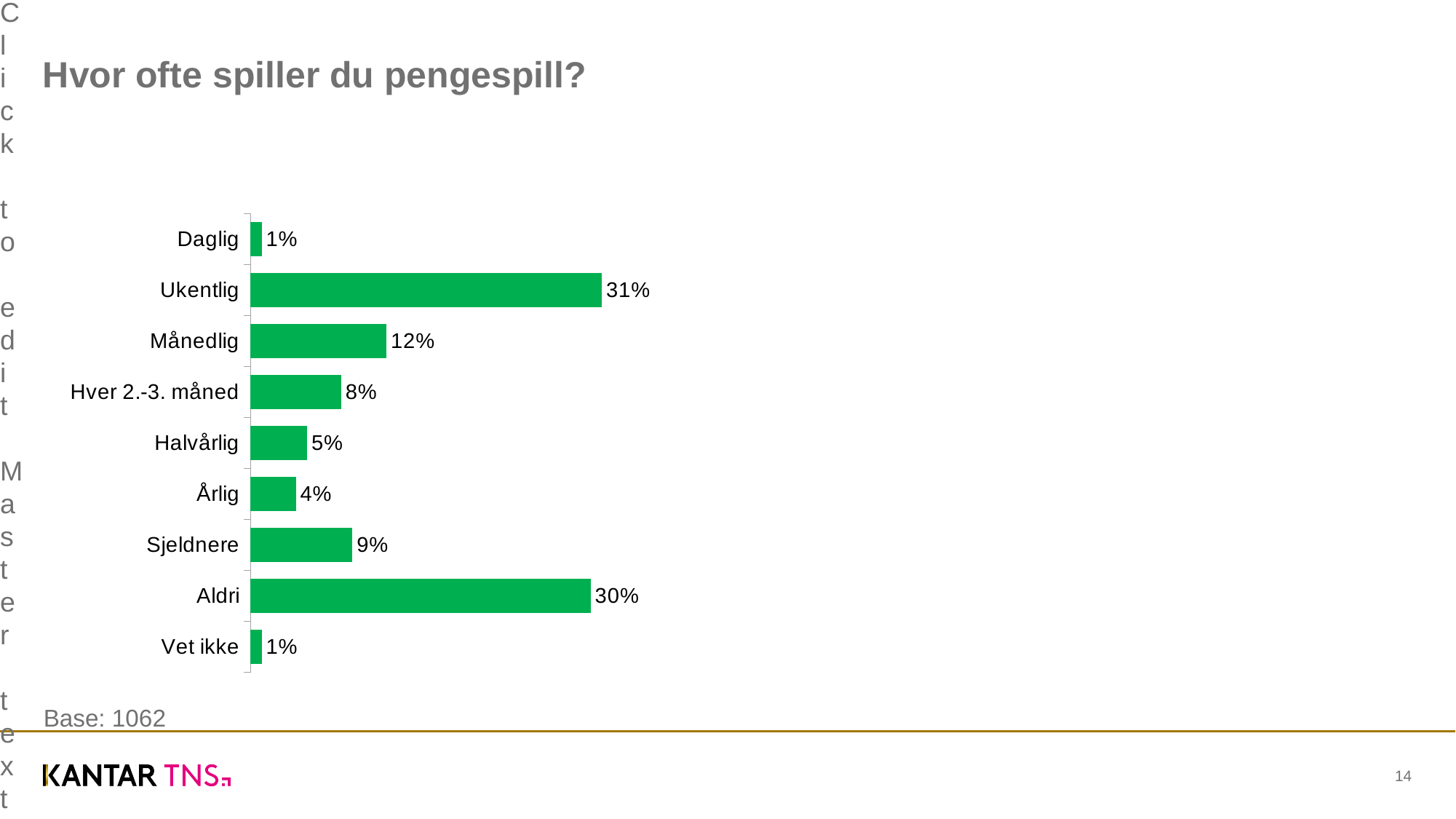
What is the difference between the values for "Månedlig" and "Årlig"? 8% What is the value shown for "Aldri"? 30% What type of chart is shown on the slide? Bar chart How many categories are shown in the chart? 9 What is the value for "Sjeldnere"? 9% What is the base (number of respondents) stated on the slide? 1062 What percentage is shown for "Hver 2.-3. måned"? 8% Which category has the lowest value, "Månedlig" or "Halvårlig"? Halvårlig What percentage of respondents answered "Ukentlig"? 31% Is the value for "Månedlig" larger than the value for "Sjeldnere"? Yes What is the difference between the values for "Ukentlig" and "Aldri"? 1% Which category has the highest value? Ukentlig